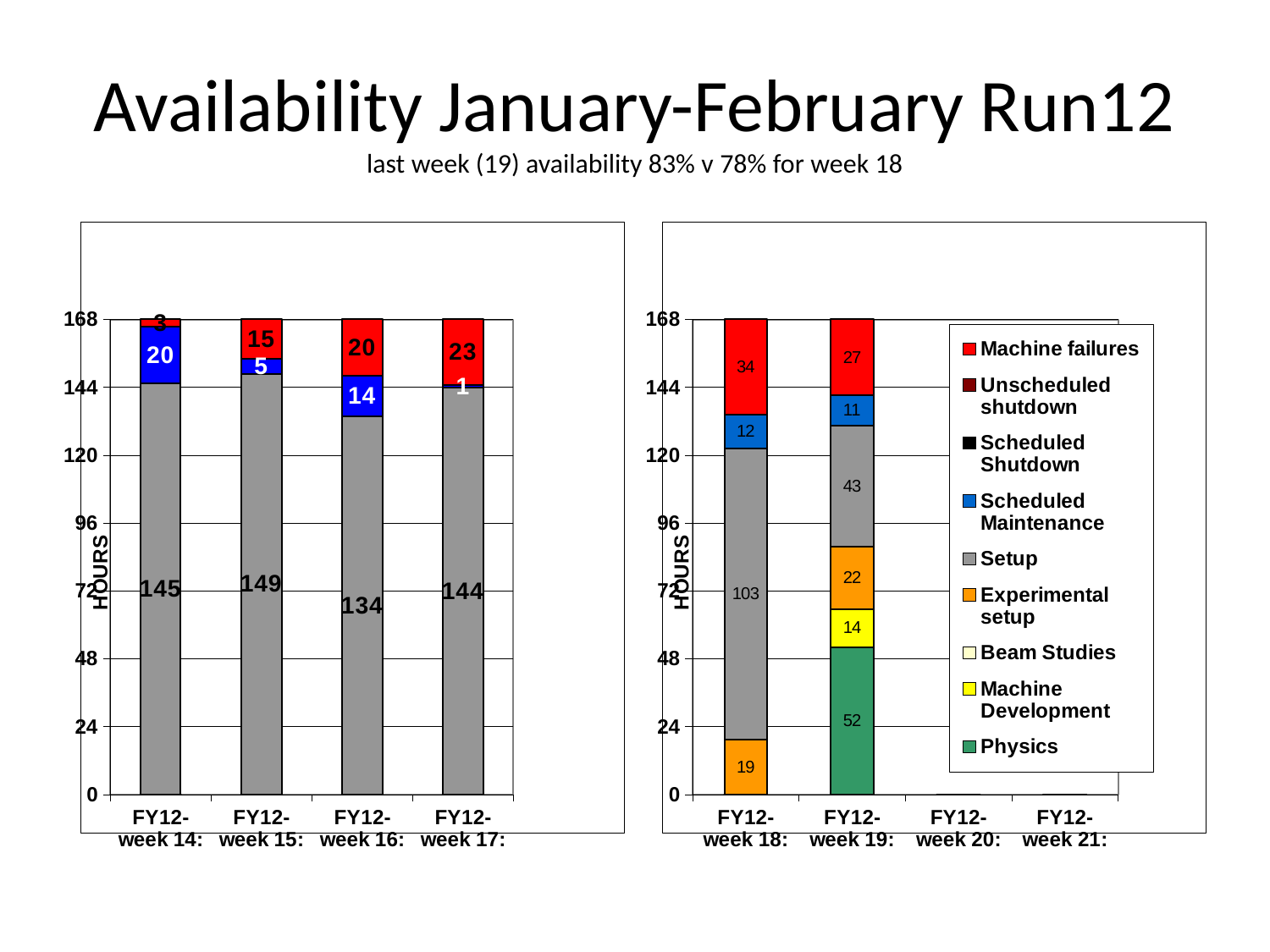
In the right chart (weeks 18-21), is the Setup value larger for FY12-week 18 or FY12-week 19? FY12-week 18 In the right chart (weeks 18-21), what is the difference between the Machine failures values for FY12-week 18 and FY12-week 19? 7 In the left chart (weeks 14-17), which week has the largest grey (Setup) segment? FY12-week 15 In the left chart (weeks 14-17), which week has the smallest grey (Setup) segment? FY12-week 16 In the left chart (weeks 14-17), what is the value of the blue (Scheduled Maintenance) segment for FY12-week 16? 14 How many series does the legend of the right chart list? 9 What kind of chart is shown on the right side of the slide? Stacked bar chart In the left chart (weeks 14-17), what is the value of the red (Machine failures) segment for FY12-week 17? 23 In the left chart (weeks 14-17), what is the difference between the red segment for FY12-week 17 and the red segment for FY12-week 15? 8 In the left chart (weeks 14-17), what is the value of the grey (Setup) segment for FY12-week 14? 145 In the right chart (weeks 18-21), what is the Physics value for FY12-week 19? 52 In the right chart (weeks 18-21), what is the Machine failures value for FY12-week 18? 34